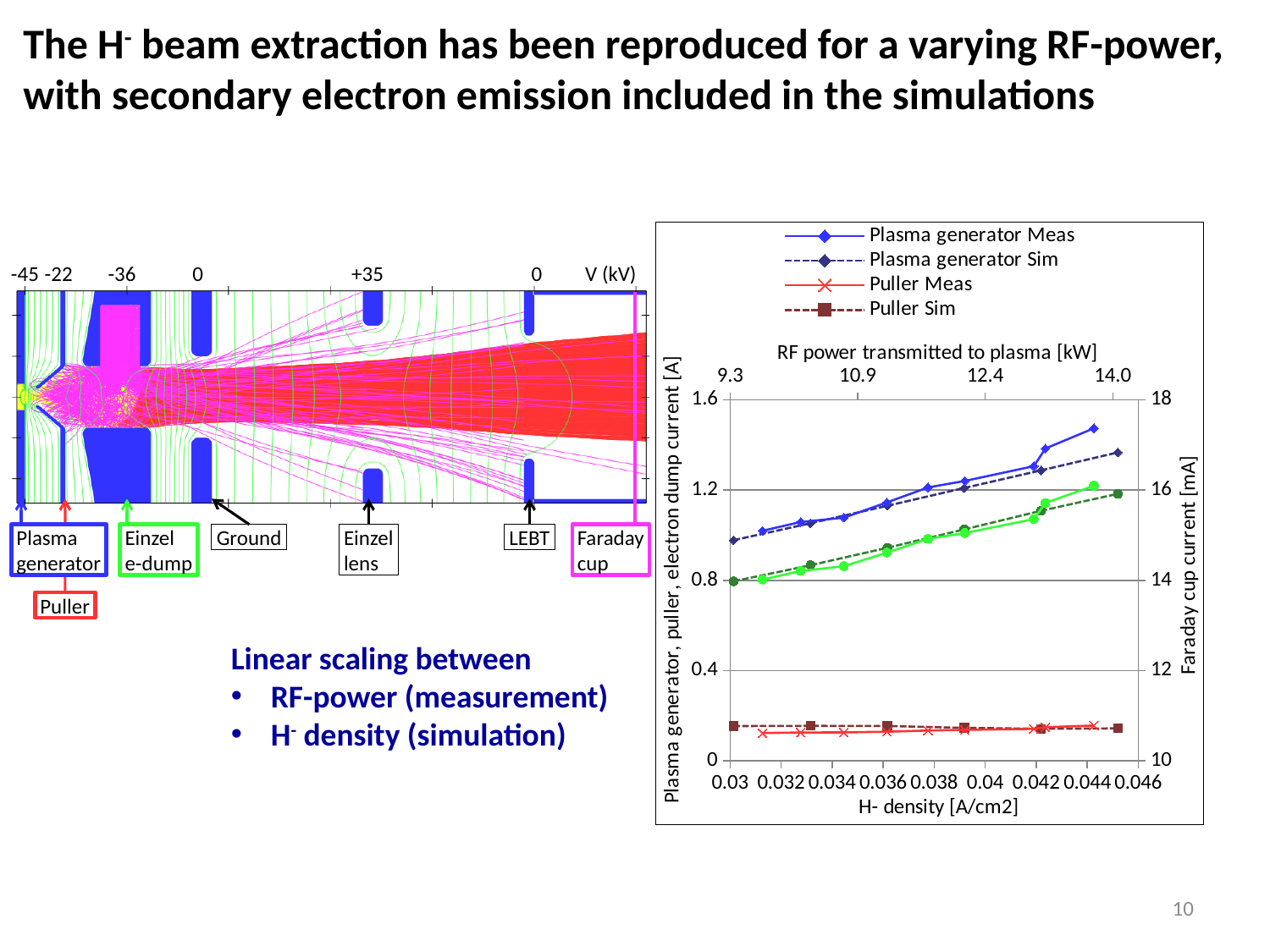
Is the highest value of Plasma generator Meas greater or less than 1.2? greater What is the title of the bottom x axis of the chart? H- density [A/cm2] Is the value of Plasma generator Meas at an H- density of 0.03 greater or less than 0.8? greater Is the value of Plasma generator Meas at an H- density of 0.03 greater or less than 1.2? less Does the Plasma generator Meas series rise or fall as H- density increases? rises Which of the legend series has the lowest values across the chart: Plasma generator Meas or Puller Meas? Puller Meas How many series does the chart legend list? 4 Does the Plasma generator Sim series rise or fall as H- density increases? rises What kind of chart is shown on the slide? line chart Which series does the legend list first? Plasma generator Meas At an H- density of 0.03, which is larger: Plasma generator Meas or Puller Sim? Plasma generator Meas